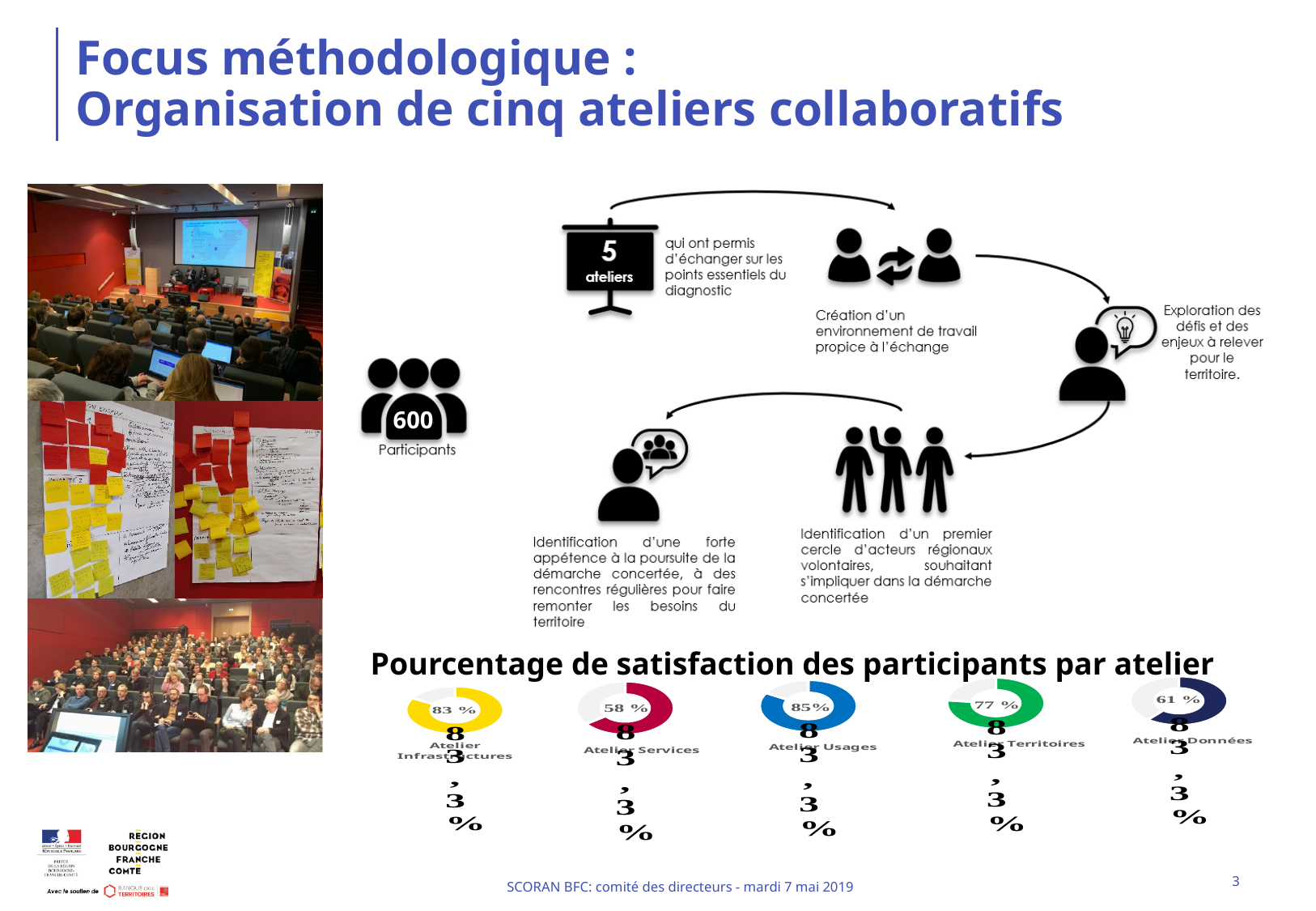
How many ateliers are shown in the satisfaction charts at the bottom of the slide? 5 Among the satisfaction charts at the bottom of the slide, which atelier has the lowest satisfaction percentage? Atelier Services In the 'Pourcentage de satisfaction des participants par atelier' charts, what is the satisfaction percentage for Atelier Infrastructures? 83 % In the 'Pourcentage de satisfaction des participants par atelier' charts, what is the satisfaction percentage for Atelier Données? 61 % In the 'Pourcentage de satisfaction des participants par atelier' charts, what is the satisfaction percentage for Atelier Services? 58 % In the 'Pourcentage de satisfaction des participants par atelier' charts, what is the satisfaction percentage for Atelier Territoires? 77 % What is the title above the satisfaction charts at the bottom of the slide? Pourcentage de satisfaction des participants par atelier In the satisfaction charts, which has a higher satisfaction percentage: Atelier Territoires or Atelier Données? Atelier Territoires In the satisfaction charts, what is the difference in percentage points between Atelier Usages and Atelier Services? 27 In the 'Pourcentage de satisfaction des participants par atelier' charts, what is the satisfaction percentage for Atelier Usages? 85% What kind of chart is used to show the satisfaction percentage per atelier? Donut (pie) chart Among the satisfaction charts at the bottom of the slide, which atelier has the highest satisfaction percentage? Atelier Usages